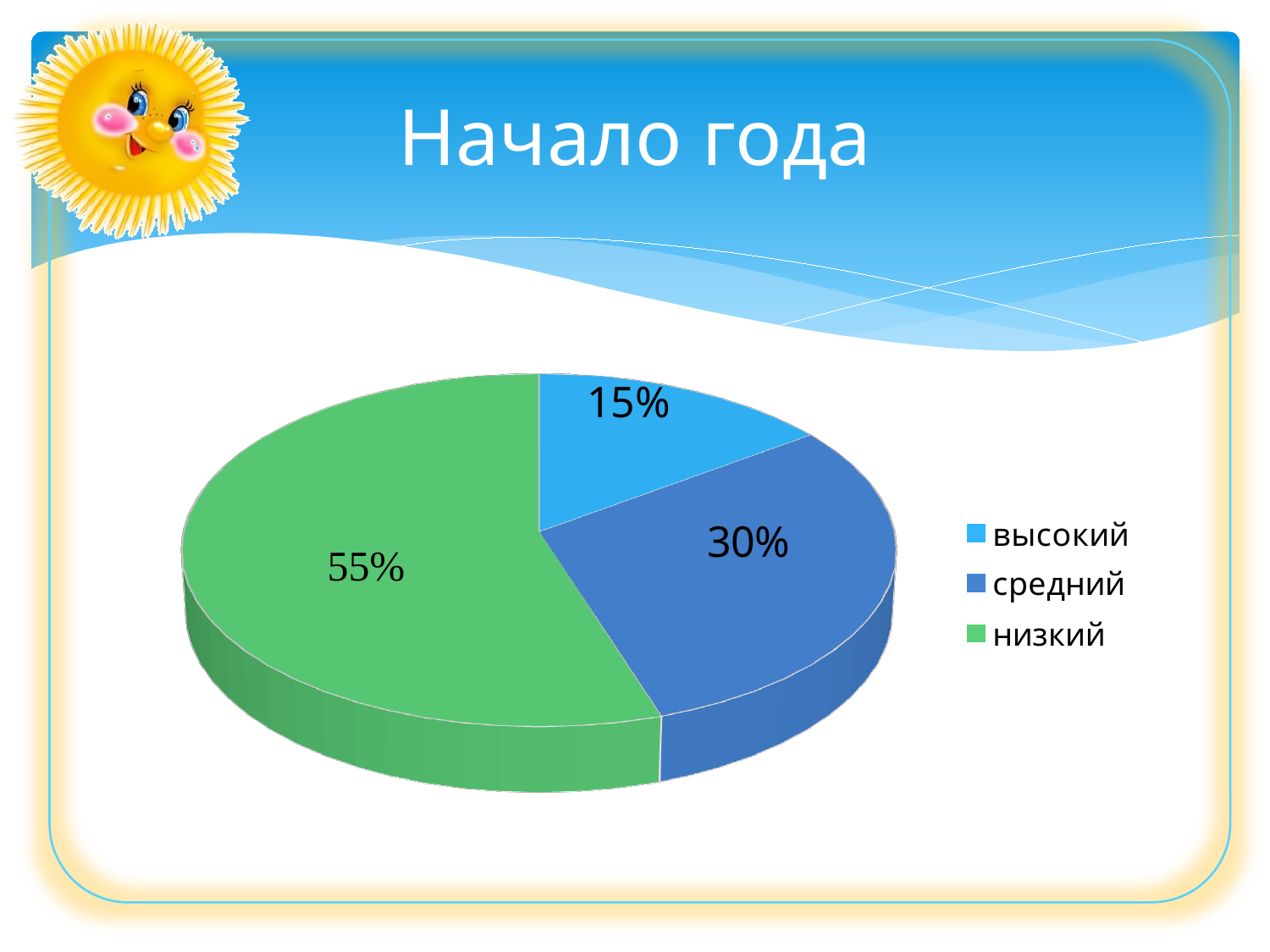
What is the value for высокий? 15% What is the difference between the values for низкий and средний? 25% What is the difference between the values for средний and высокий? 15% How many categories does the pie chart have? 3 What is the value for средний? 30% What colour is the slice for низкий? green Which category has the largest share of the pie? низкий What is the value for низкий? 55% What is the title of the slide containing the chart? Начало года Which is larger, the value for средний or the value for высокий? средний Which category has the smallest share of the pie? высокий What kind of chart is shown on the slide? pie chart